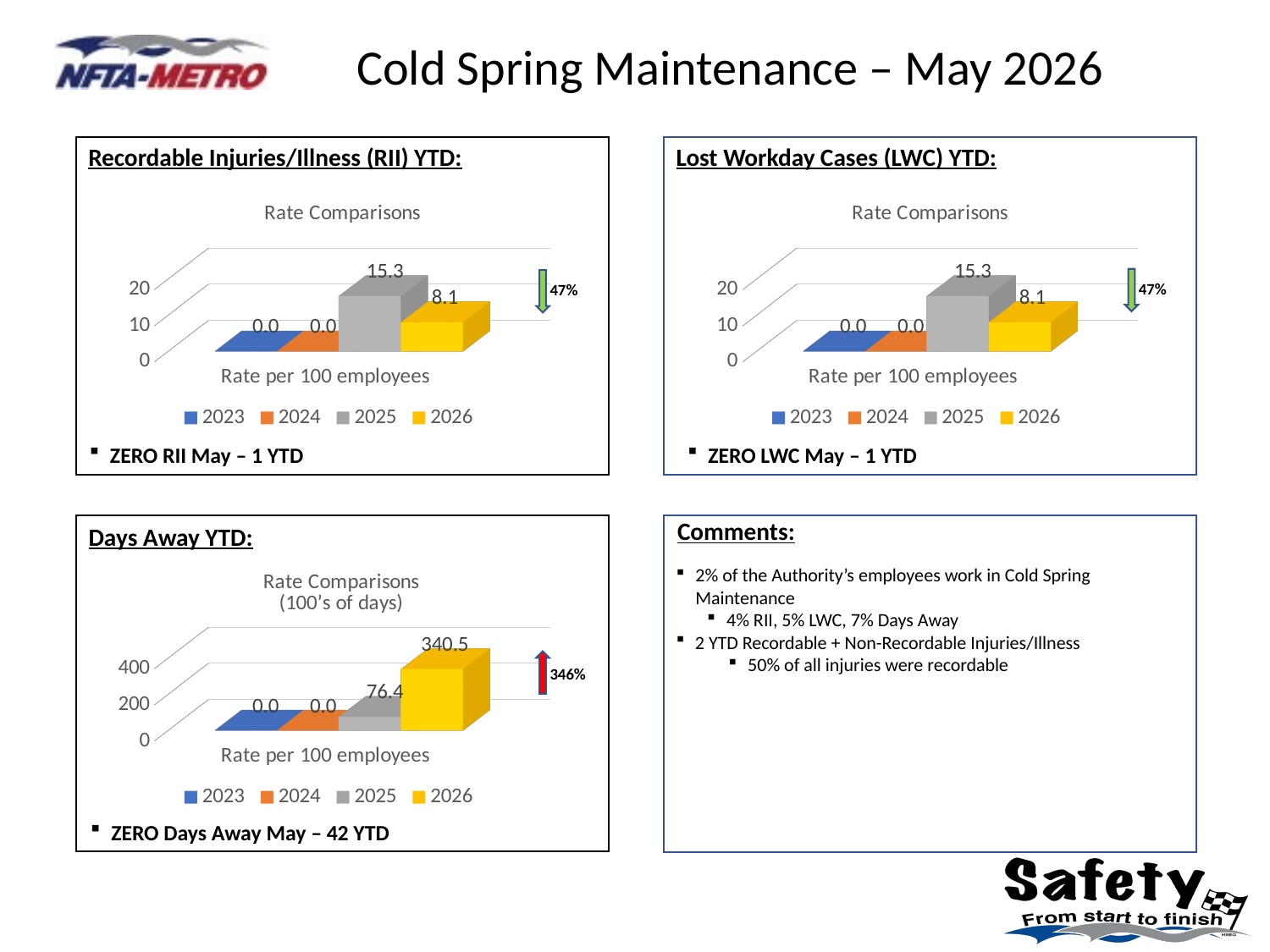
In the Recordable Injuries/Illness (RII) YTD chart, what is the difference between the 2025 and 2026 values? 7.2 What kind of chart is the Days Away YTD chart? Bar chart In the Days Away YTD chart, what is the value for 2025? 76.4 How many series does the legend list in the Lost Workday Cases (LWC) YTD chart? 4 In the Recordable Injuries/Illness (RII) YTD chart, what is the value for 2025? 15.3 In the Days Away YTD chart, what is the value for 2026? 340.5 In the Days Away YTD chart, what is the difference between the 2026 and 2025 values? 264.1 In the Days Away YTD chart, which year has the highest value? 2026 In the Recordable Injuries/Illness (RII) YTD chart, what is the value for 2026? 8.1 In the Recordable Injuries/Illness (RII) YTD chart, which year has the highest rate? 2025 In the Lost Workday Cases (LWC) YTD chart, which is larger, the value for 2025 or the value for 2026? 2025 In the Lost Workday Cases (LWC) YTD chart, what is the value for 2024? 0.0